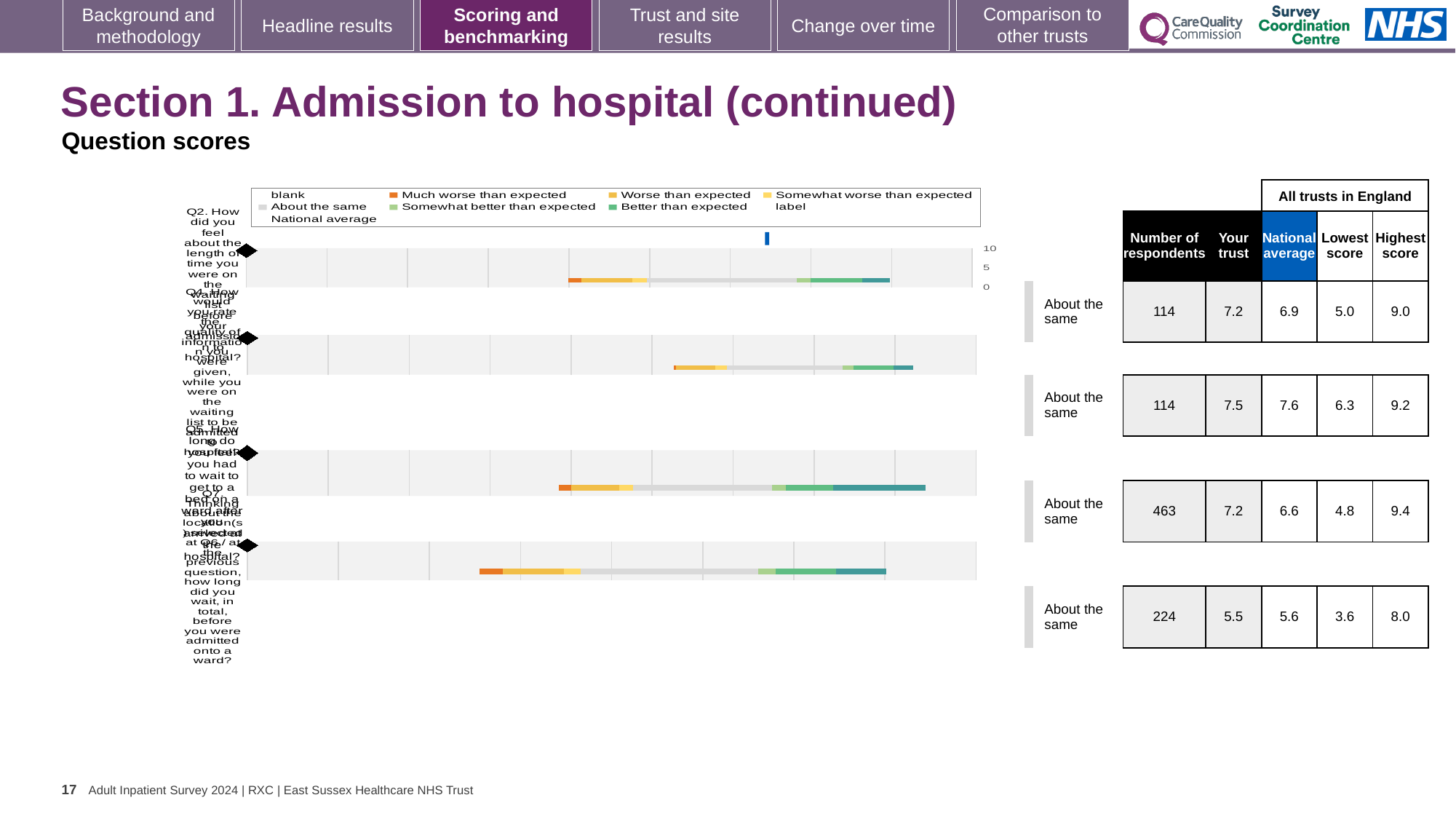
In the first row of the table, what is the difference between the Highest score and the Lowest score? 4.0 What kind of chart is shown on the slide? bar chart What benchmark label is shown to the right of each of the four bars? About the same What heading spans the National average, Lowest score and Highest score columns in the table? All trusts in England In the second row of the table, which is larger: the Your trust score or the National average? National average Which row of the table has the largest number of respondents? the third row (463) In the table, what is the Lowest score in the third row? 4.8 In the table, what is the number of respondents in the first (top) row? 114 How many question bars are plotted in the chart? 4 In the table, what is the Highest score in the bottom row? 8.0 In the table, what is the Your trust score in the third row? 7.2 Which row of the table has the lowest Your trust score? the bottom row (5.5)